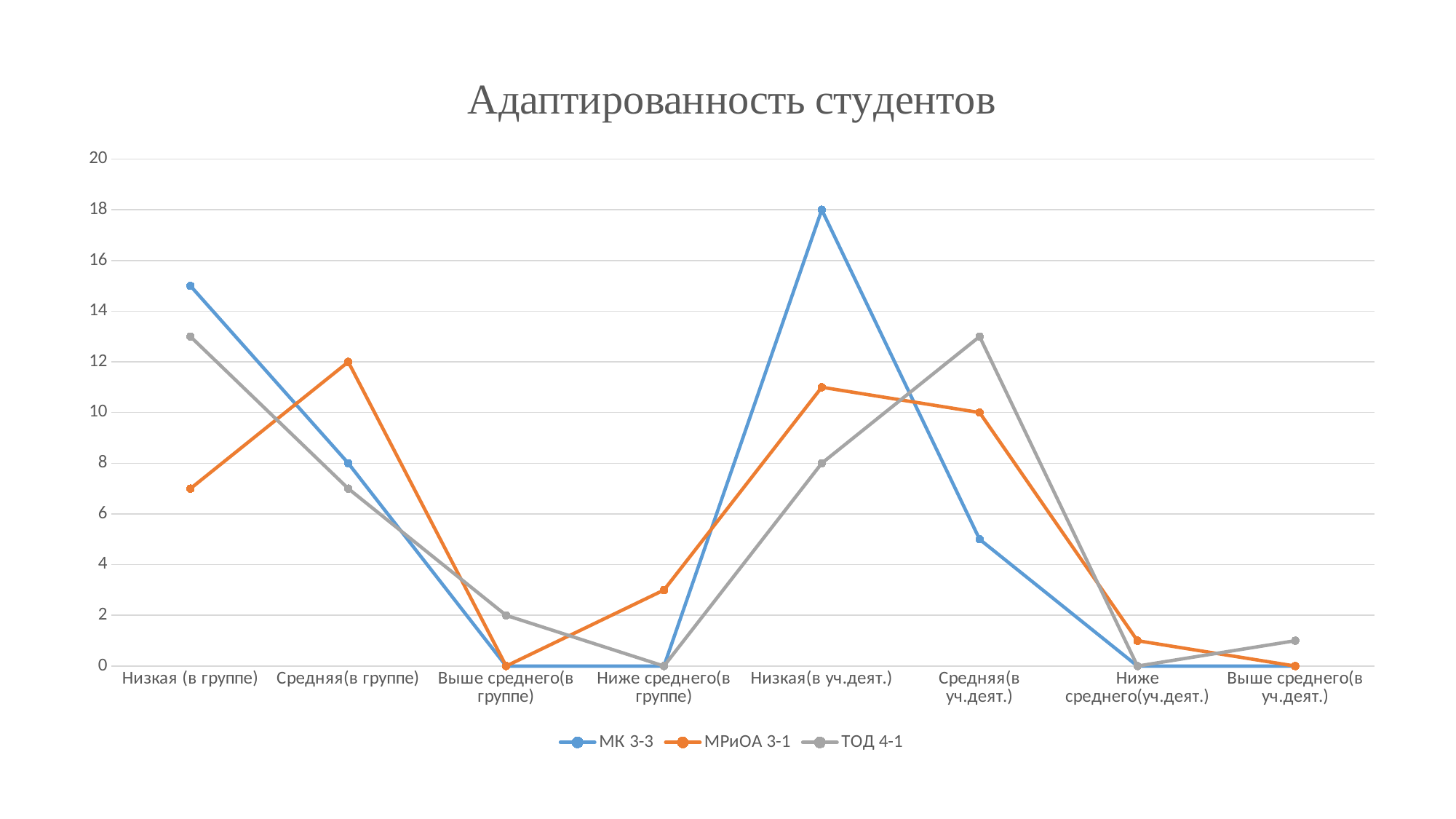
What kind of chart is shown on the slide? line chart What is the value for МРиОА 3-1 at Средняя(в уч.деят.)? 10 What is the value for ТОД 4-1 at Низкая(в уч.деят.)? 8 What is the value for МК 3-3 at Низкая(в уч.деят.)? 18 At which category does МК 3-3 reach its highest value? Низкая(в уч.деят.) What is the value for МРиОА 3-1 at Средняя(в группе)? 12 At Средняя(в группе), which series has the larger value, МК 3-3 or МРиОА 3-1? МРиОА 3-1 What is the difference between МК 3-3 and ТОД 4-1 at Низкая(в уч.деят.)? 10 How many series does the legend list? 3 Is the value for МК 3-3 at Низкая (в группе) greater or less than 14? greater What is the title of the chart? Адаптированность студентов How many categories are shown on the x axis? 8